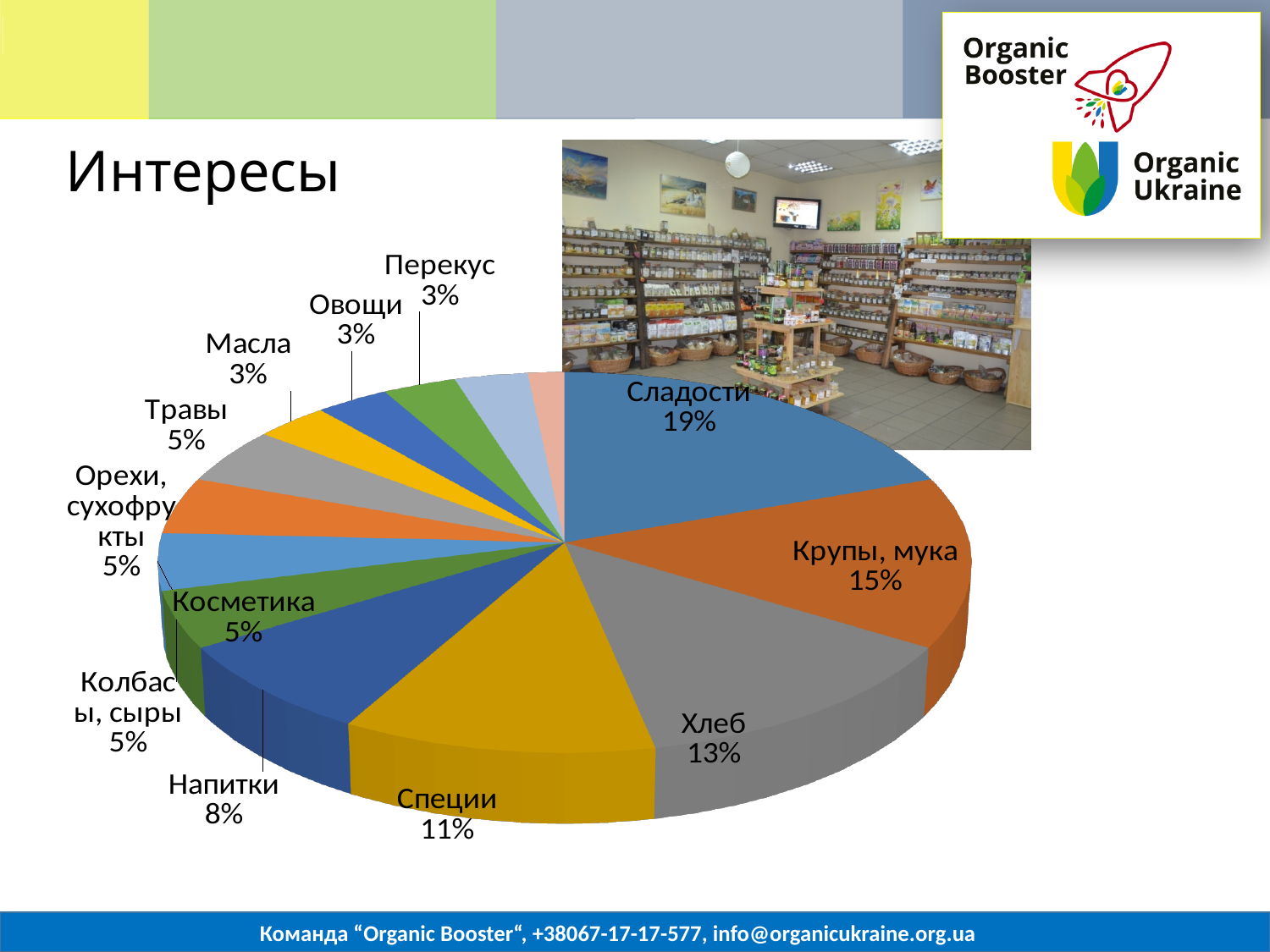
What is the value for Специи? 11% What is the value shown for Косметика? 5% What is the difference between the shares of Сладости and Крупы, мука? 4% What percentage is shown for Напитки? 8% Which is larger, Хлеб or Специи? Хлеб Which labeled category has the largest share of the pie? Сладости What is the title of the slide containing the chart? Интересы What kind of chart is shown on the slide? pie chart What is the value shown for Крупы, мука? 15% What share of the pie does Сладости have? 19% What percentage is shown for Хлеб? 13% What is the difference between the shares of Напитки and Травы? 3%